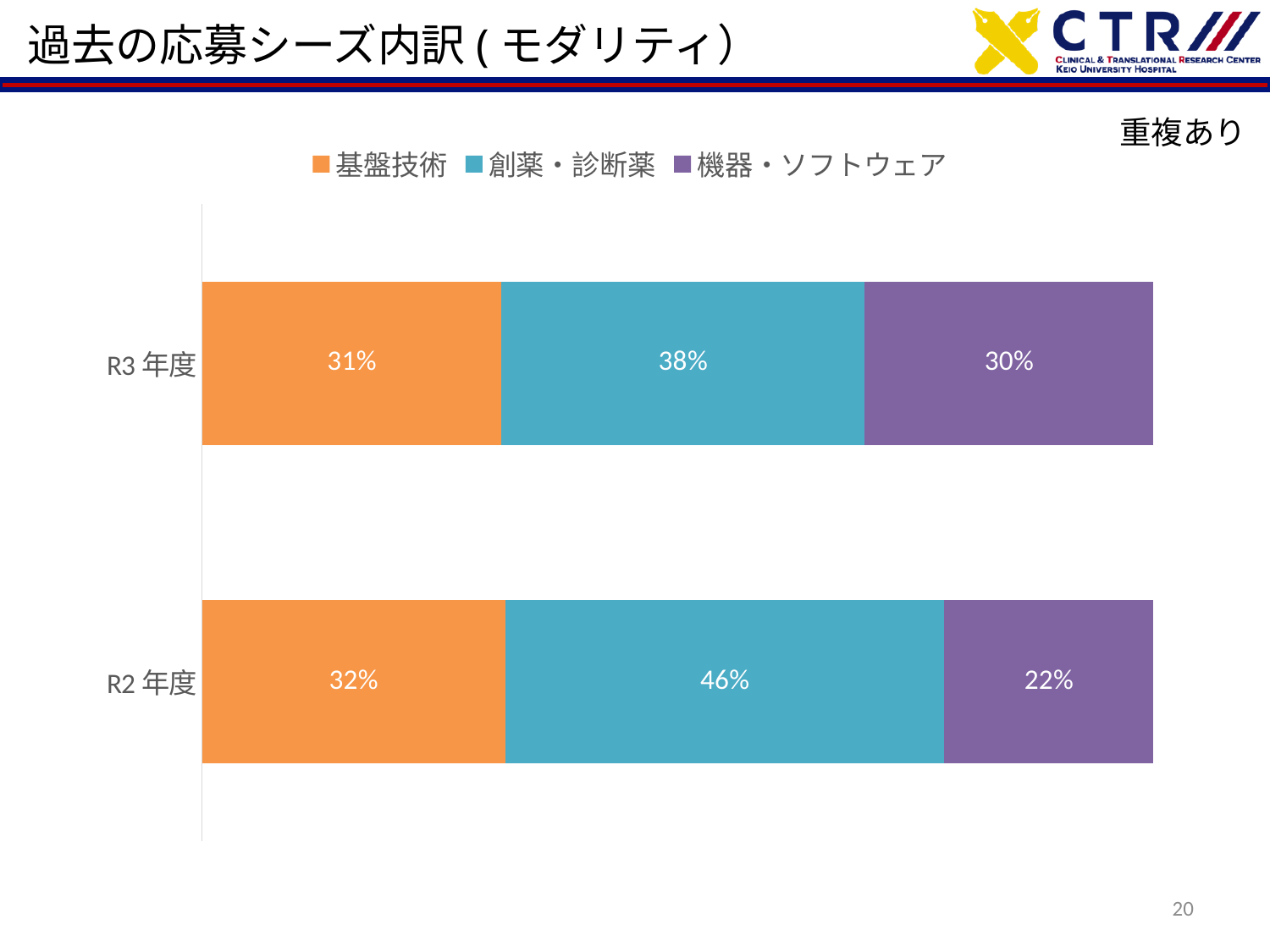
How many series does the legend list? 3 What is the difference between the 創薬・診断薬 values for R2年度 and R3年度? 8% What is the value for 創薬・診断薬 in R3年度? 38% What is the value for 創薬・診断薬 in R2年度? 46% What kind of chart is shown on the slide? Stacked bar chart What is the total of the stacked bar for R3年度? 99% Which series has the lowest value in R2年度? 機器・ソフトウェア What is the value for 基盤技術 in R3年度? 31% Which series has the highest value in R2年度? 創薬・診断薬 How many categories (years) are shown on the chart? 2 Which is larger: 機器・ソフトウェア in R3年度 or 機器・ソフトウェア in R2年度? R3年度 What is the value for 機器・ソフトウェア in R2年度? 22%